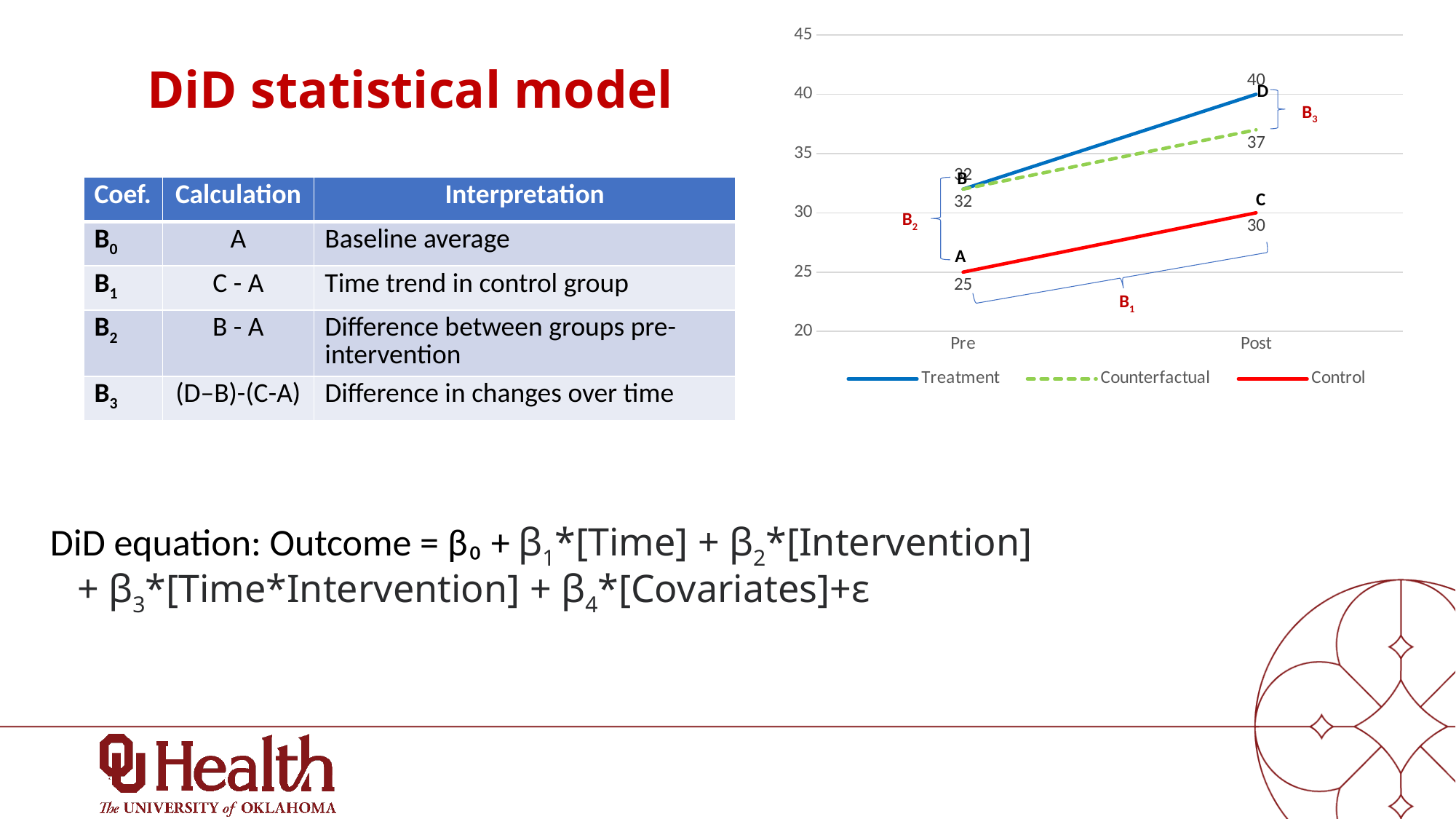
How many series does the chart legend list? 3 What is the value of the Counterfactual series at Post? 37 Does the Treatment series rise or fall from Pre to Post? rise Which series has the highest value at Post? Treatment What is the value of the Treatment series at Post? 40 Which series is drawn with a dashed line in the chart? Counterfactual By how much does the Control series increase from Pre to Post? 5 What type of chart is shown on the slide? line chart What is the value of the Control series at Post? 30 What is the value of the Control series at Pre? 25 Which series has the lowest value at Pre? Control What is the difference between the Treatment and Counterfactual values at Post? 3